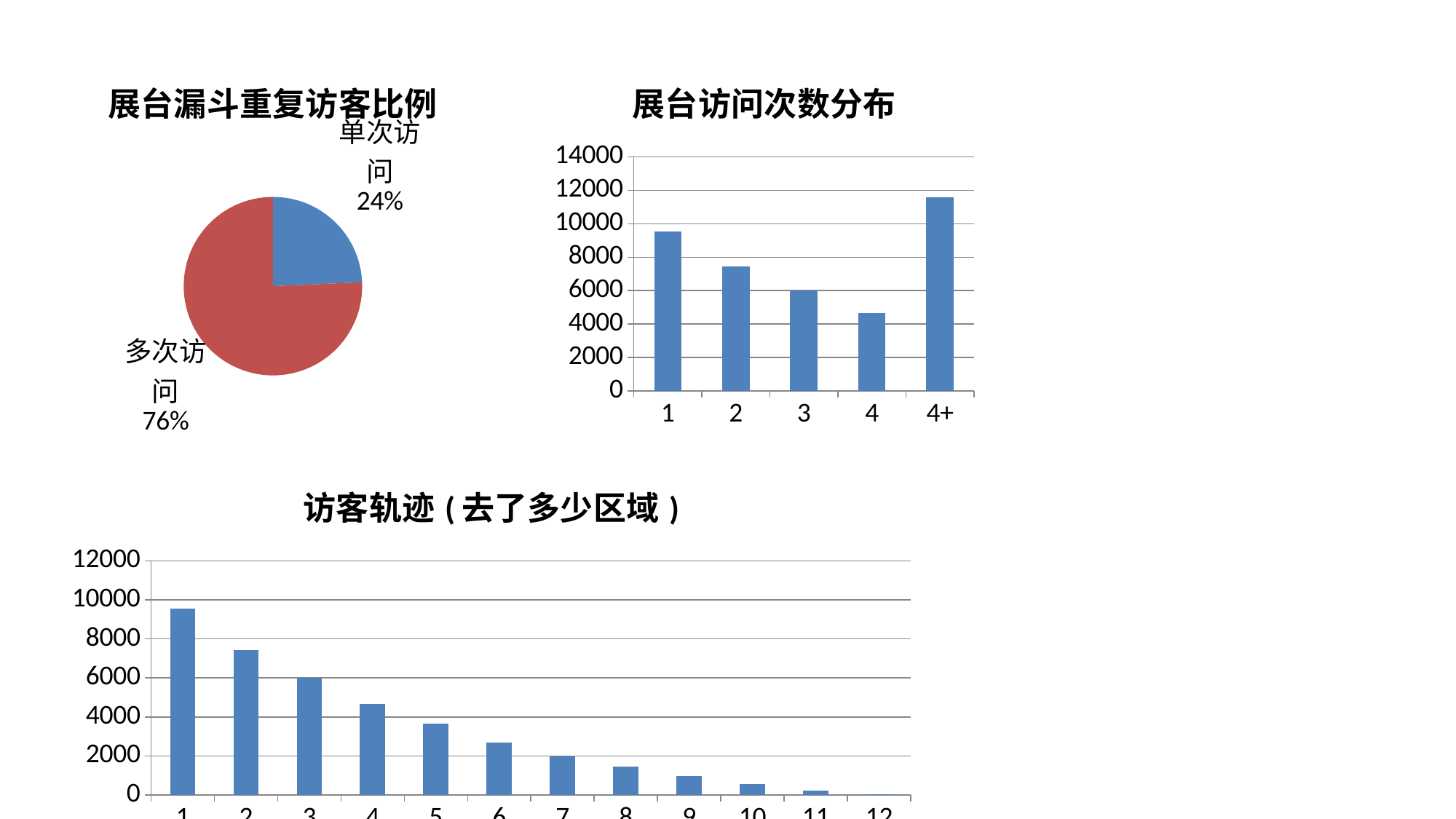
In the pie chart 展台漏斗重复访客比例, what percentage is shown for 单次访问? 24% How many categories are shown on the x axis of the chart 展台访问次数分布? 5 In the chart 展台访问次数分布, which category has the lowest value? 4 In the chart 访客轨迹（去了多少区域）, is the value for category 5 greater or less than 4000? less What kind of chart is 展台漏斗重复访客比例? Pie chart In the pie chart 展台漏斗重复访客比例, what share of the pie does 多次访问 take? 76% In the pie chart 展台漏斗重复访客比例, which slice is larger, 单次访问 or 多次访问? 多次访问 In the chart 访客轨迹（去了多少区域）, do the values rise or fall as the number of areas increases along the x axis? Fall In the chart 展台访问次数分布, is the value for category 1 greater or less than 8000? greater In the pie chart 展台漏斗重复访客比例, by how many percentage points does 多次访问 exceed 单次访问? 52 percentage points What kind of chart is 访客轨迹（去了多少区域）? Bar chart In the chart 展台访问次数分布, which category has the highest value? 4+